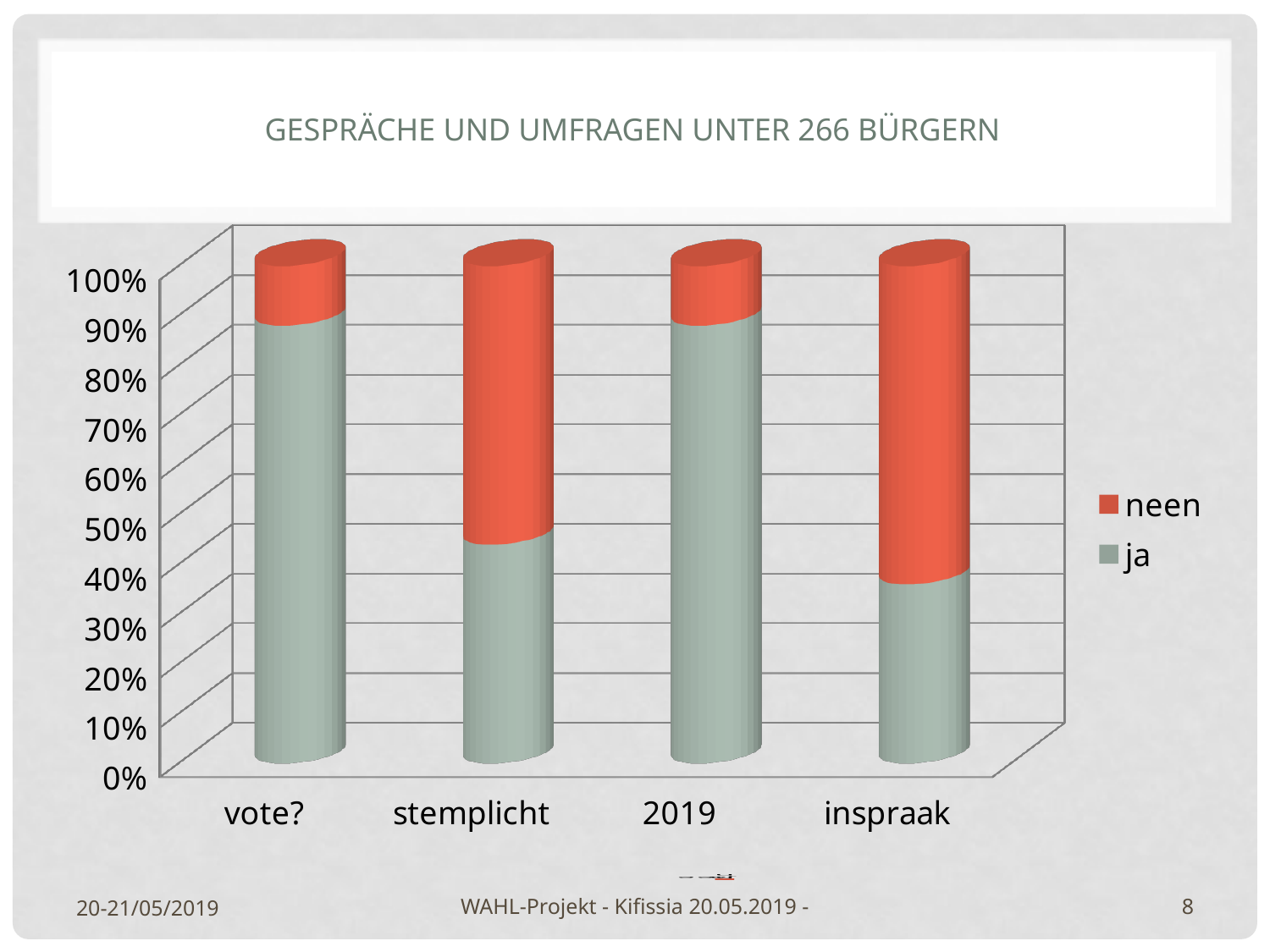
Is the 'ja' share for 'inspraak' greater or less than 50%? less What is the title of the slide containing the chart? GESPRÄCHE UND UMFRAGEN UNTER 266 BÜRGERN Which colour represents the 'neen' series in the chart? Red How many series does the chart legend list? 2 Is the 'ja' share for 'stemplicht' greater or less than 60%? less Which has the larger 'ja' share, 'vote?' or 'stemplicht'? vote? Which category has the smallest 'ja' share? inspraak Is the 'neen' share for '2019' greater or less than 20%? less What kind of chart is shown on the slide? Stacked bar chart How many categories are shown on the x axis of the chart? 4 Which has the larger 'neen' share, 'inspraak' or '2019'? inspraak